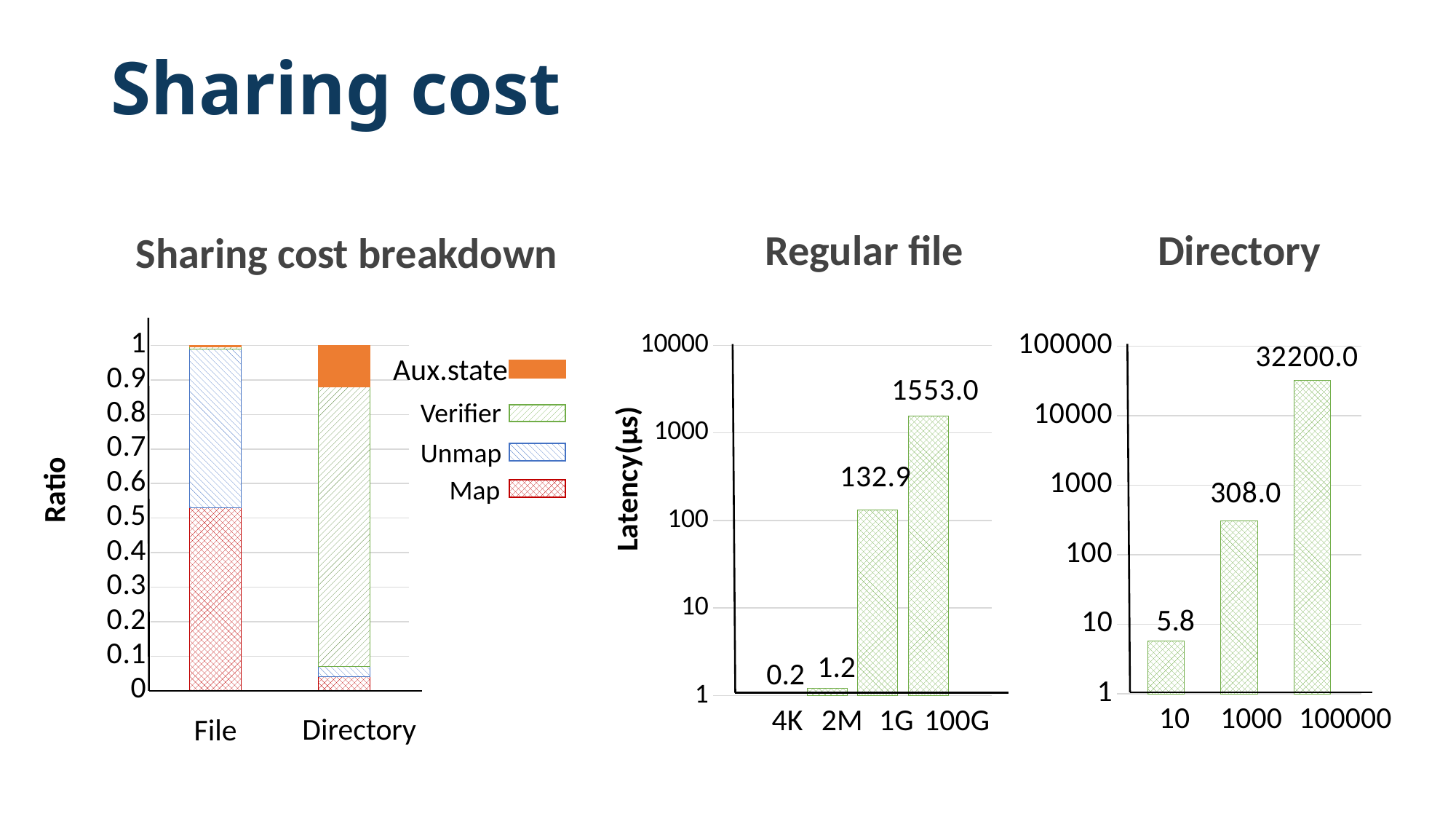
In the Regular file chart, what is the latency for 1G? 132.9 In the Regular file chart, what is the latency for 100G? 1553.0 In the Directory chart, which category has the highest latency? 100000 In the Directory chart, do the latency values rise or fall from left to right along the x axis? rise In the Sharing cost breakdown chart, is the Map ratio for File greater or less than 0.5? greater How many series does the legend of the Sharing cost breakdown chart list? 4 In the Directory chart, what is the latency for 10? 5.8 How many categories are shown on the x axis of the Regular file chart? 4 In the Directory chart, what is the latency for 1000? 308.0 In the Directory chart, what is the difference in latency between 100000 and 1000? 31892.0 In the Regular file chart, which category has the lowest latency? 4K In the Regular file chart, which has the larger latency, 2M or 1G? 1G